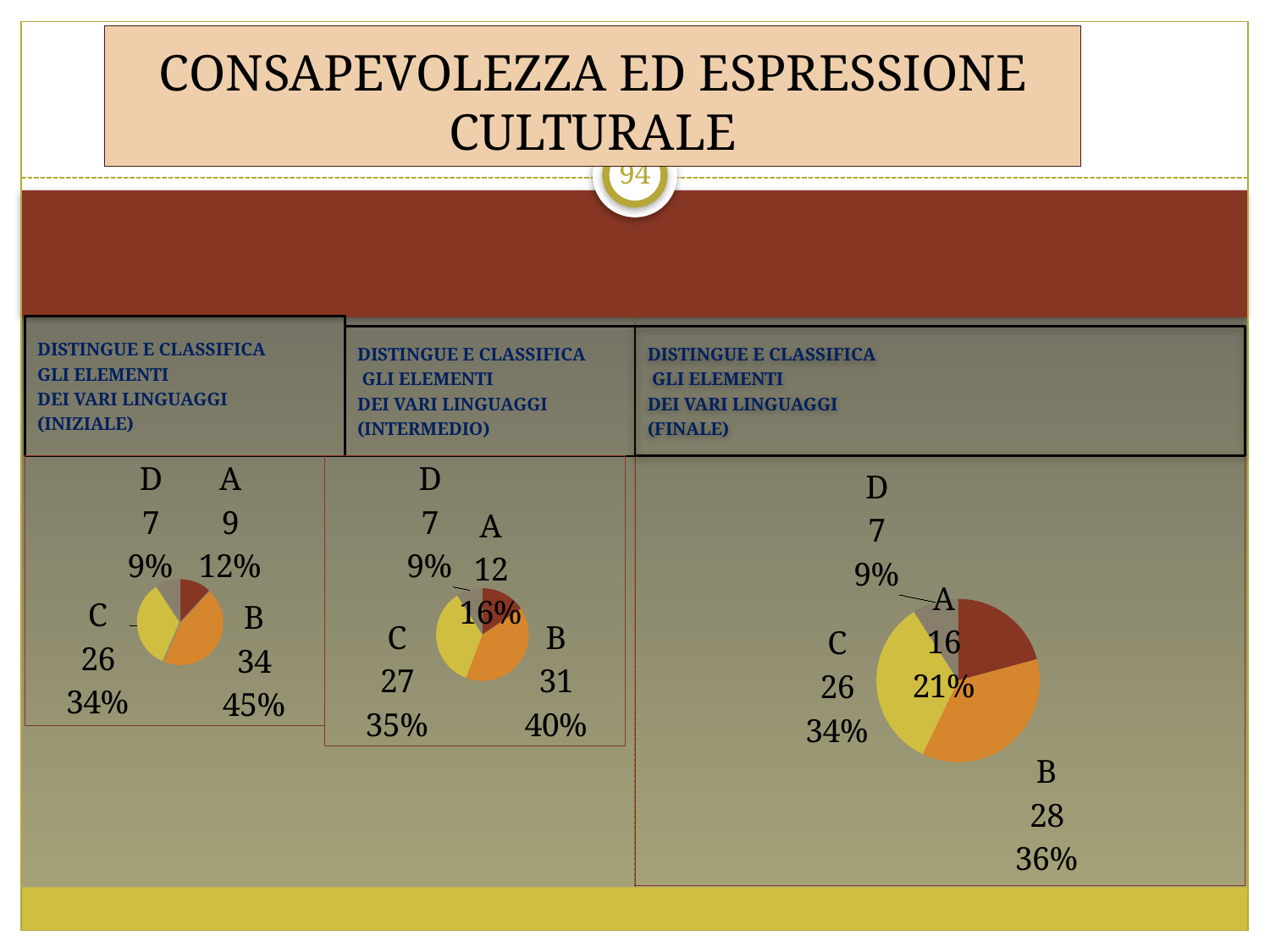
What kind of chart is used in the INIZIALE panel (left)? Pie chart How many categories does the FINALE pie chart (right) show? 4 In the FINALE pie chart (right), what is the value for category B? 28 In the INTERMEDIO pie chart (middle), which category has the largest value? B In the FINALE pie chart (right), what is the difference between the values for A and D? 9 In the INIZIALE pie chart (left), which category has the smallest value? D In the INTERMEDIO pie chart (middle), what is the value for category A? 12 In the INTERMEDIO pie chart (middle), what is the difference between the values for B and C? 4 In the INIZIALE pie chart (left), what percentage share does category C have? 34% In the FINALE pie chart (right), what percentage share does category A have? 21% In the INIZIALE pie chart (left), what is the value for category B? 34 In the FINALE pie chart (right), which is larger, the value for B or the value for C? B